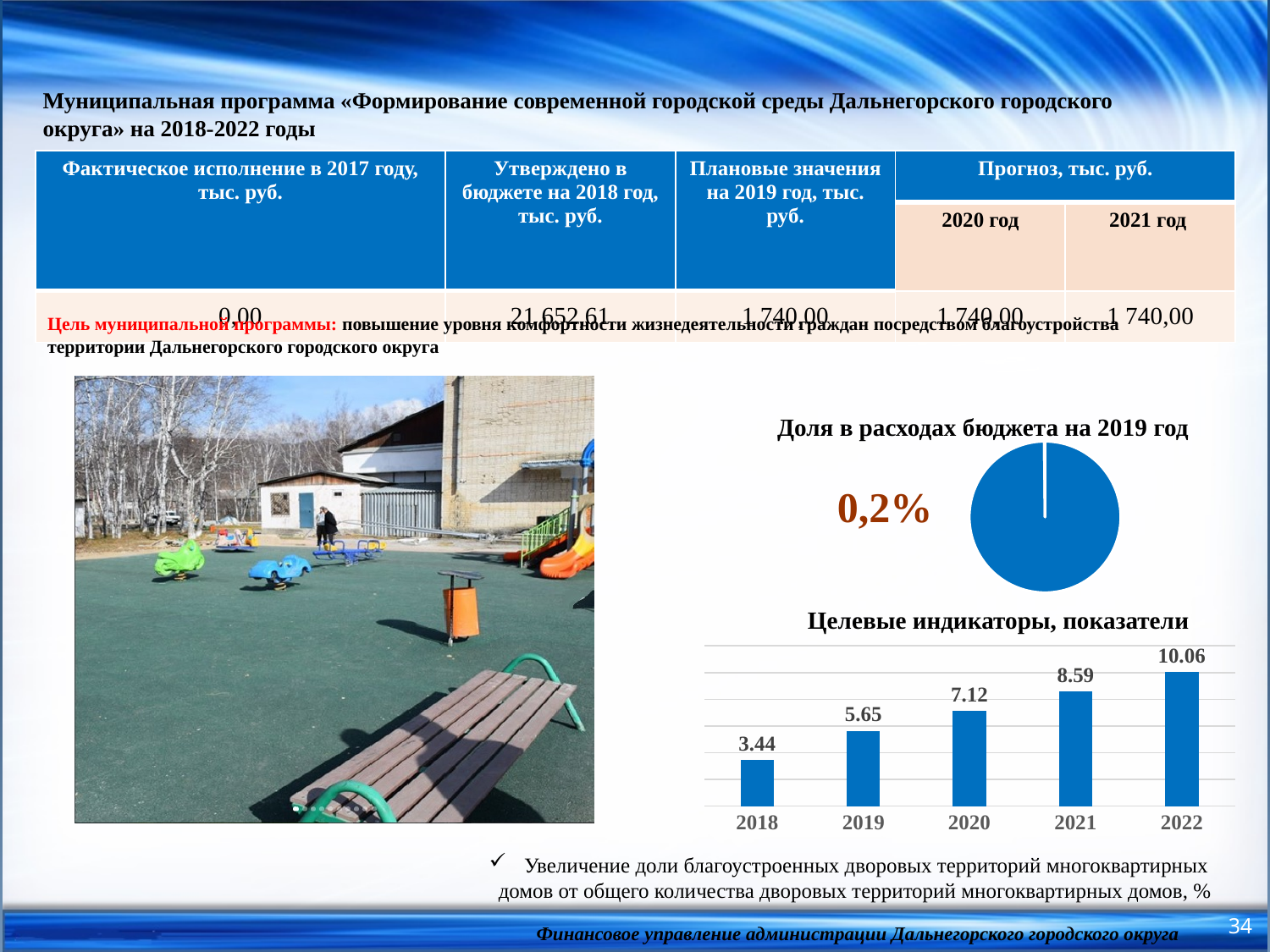
What kind of chart is «Целевые индикаторы, показатели»? Bar chart How many years are shown in the chart titled «Целевые индикаторы, показатели»? 5 In the chart titled «Целевые индикаторы, показатели», what is the value for 2020? 7.12 In the chart titled «Целевые индикаторы, показатели», what is the value for 2018? 3.44 In the chart titled «Целевые индикаторы, показатели», what is the difference between the values for 2022 and 2018? 6.62 What share is shown in the pie chart titled «Доля в расходах бюджета на 2019 год»? 0,2% In the chart titled «Целевые индикаторы, показатели», which is larger: the value for 2019 or the value for 2021? 2021 In the chart titled «Целевые индикаторы, показатели», what is the value for 2022? 10.06 In the chart titled «Целевые индикаторы, показатели», which year has the lowest value? 2018 In the chart titled «Целевые индикаторы, показатели», what is the difference between the values for 2021 and 2019? 2.94 In the chart titled «Целевые индикаторы, показатели», do the values rise or fall from 2018 to 2022? Rise In the chart titled «Целевые индикаторы, показатели», which year has the highest value? 2022